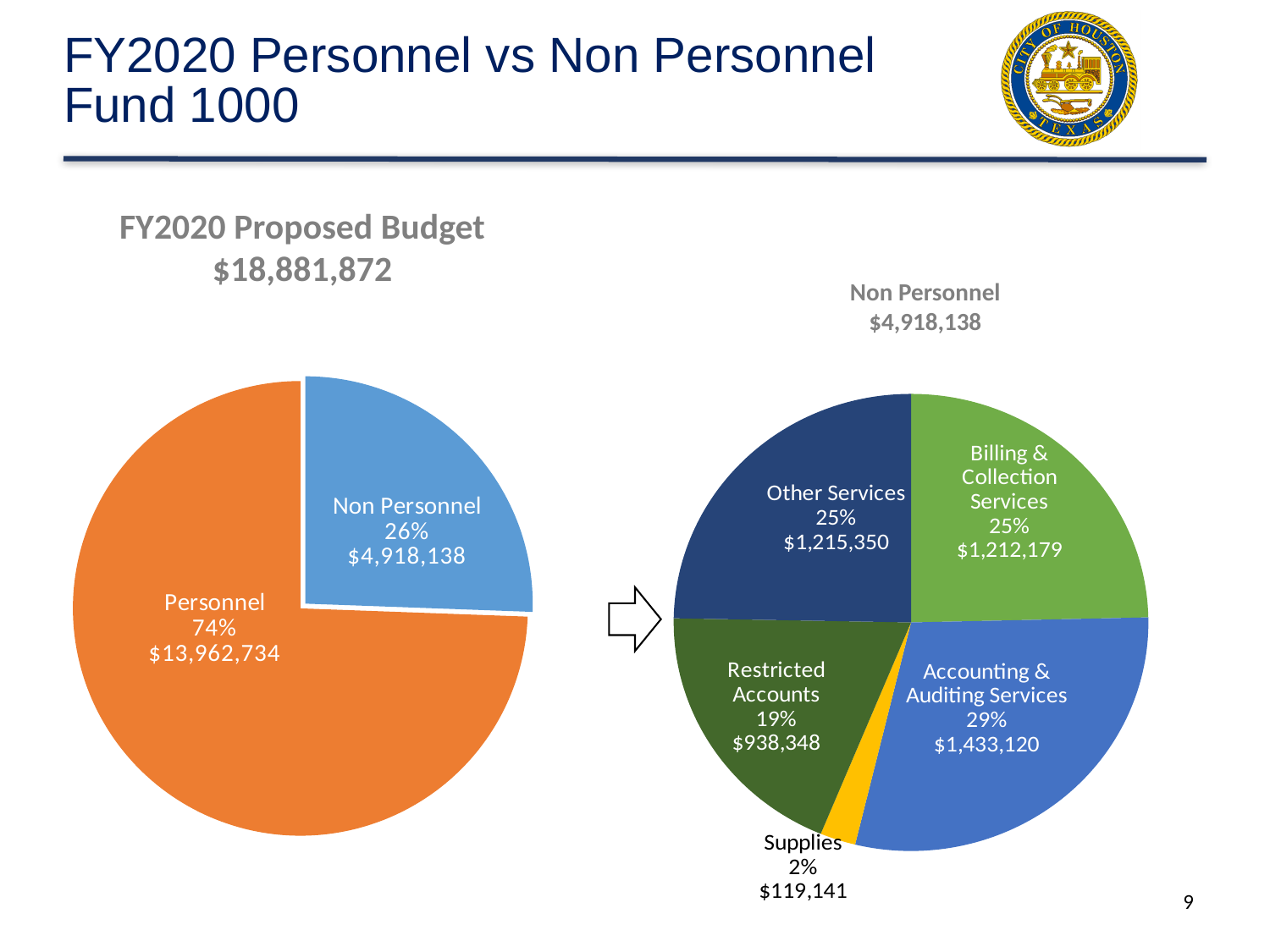
In the Non Personnel pie chart on the right, which category has the smallest value? Supplies What kind of chart is the Non Personnel chart on the right? Pie chart In the Non Personnel pie chart on the right, what share of the pie is Other Services? 25% In the Non Personnel pie chart on the right, how many slices are there? 5 In the FY2020 Proposed Budget pie chart on the left, what is the value for Personnel? $13,962,734 In the Non Personnel pie chart on the right, what is the difference between the Accounting & Auditing Services and Billing & Collection Services values? $220,941 In the Non Personnel pie chart on the right, which category has the largest value? Accounting & Auditing Services In the FY2020 Proposed Budget pie chart on the left, what is the difference between the Personnel and Non Personnel values? $9,044,596 In the Non Personnel pie chart on the right, what is the value for Restricted Accounts? $938,348 In the FY2020 Proposed Budget pie chart on the left, which slice is larger, Personnel or Non Personnel? Personnel In the FY2020 Proposed Budget pie chart on the left, what share of the pie is Non Personnel? 26% In the Non Personnel pie chart on the right, what colour is the Supplies slice? Yellow